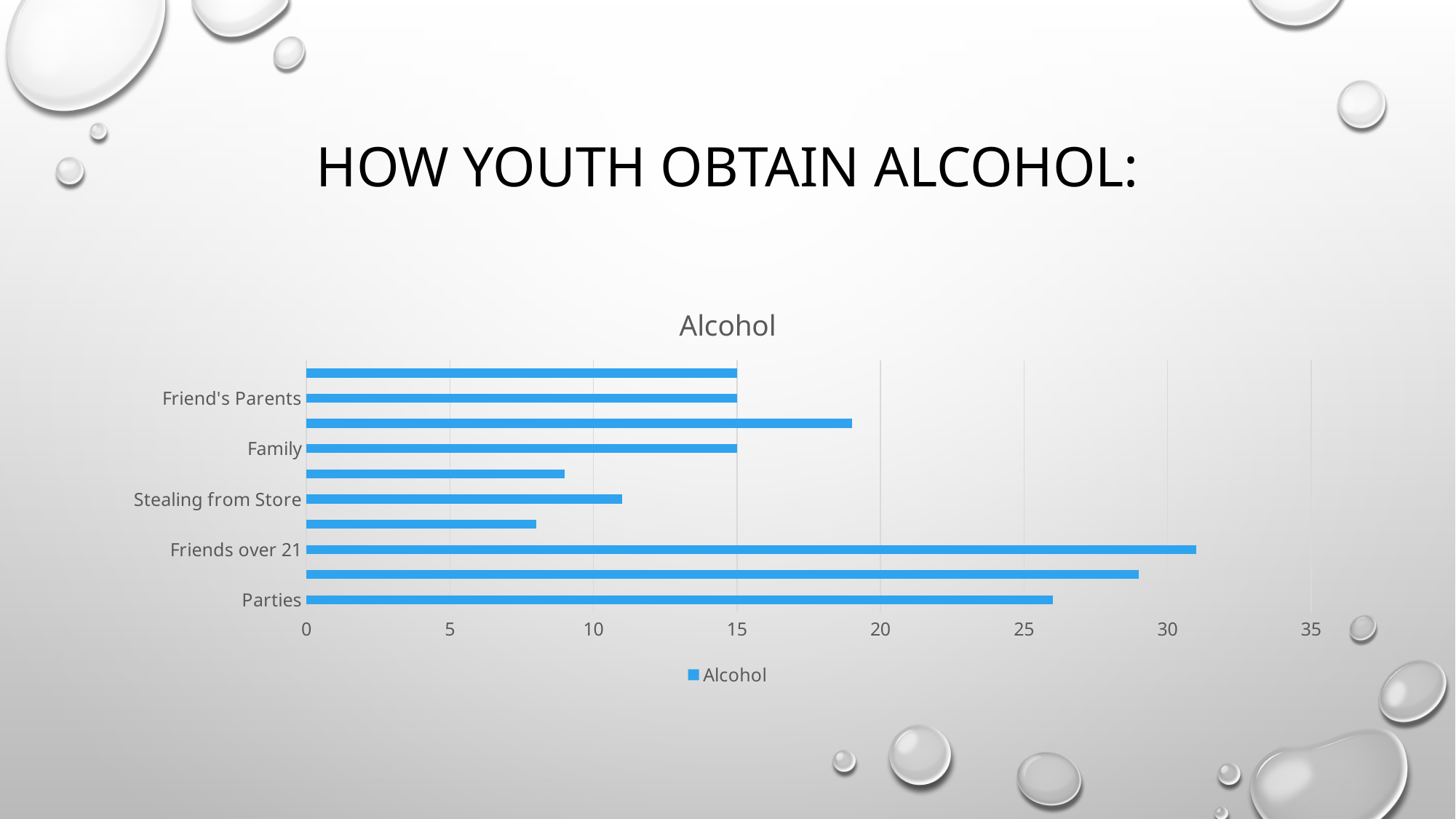
What kind of chart is shown on the slide? bar chart Is the value for Parties greater or less than 25? greater Is the value for Parties greater or less than 30? less Is the value for Stealing from Store greater or less than 10? greater What entry is shown in the chart's legend? Alcohol Which is larger, the value for Parties or the value for Stealing from Store? Parties What is the title of the chart? Alcohol What is the value for Family? 15 How many series does the legend list? 1 What is the value for Friend's Parents? 15 Which category has the highest value? Friends over 21